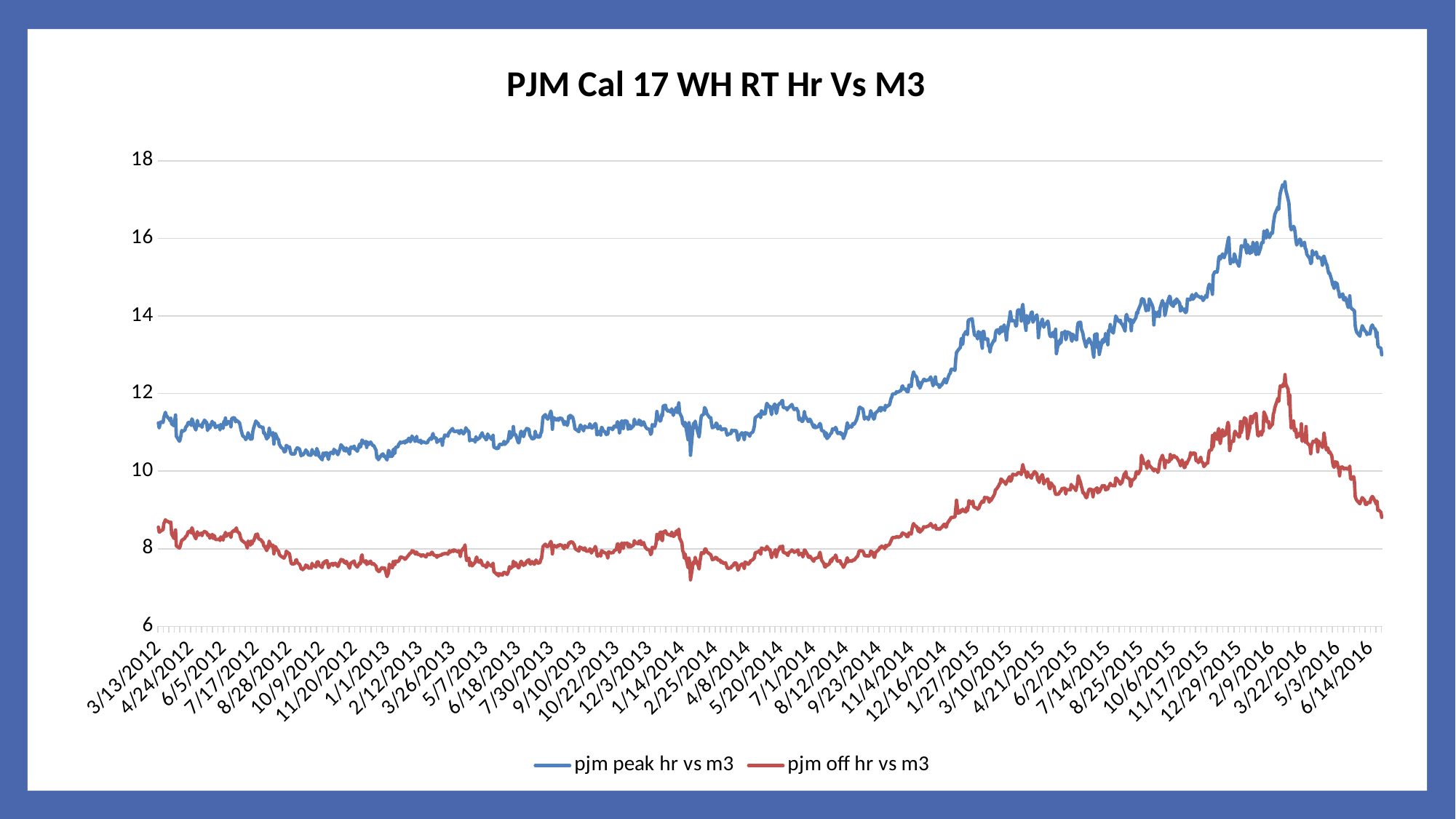
Overall, does pjm peak hr vs m3 rise or fall from 3/13/2012 to its peak around 3/22/2016? rise Is the value for pjm peak hr vs m3 at 3/13/2012 greater or less than 10? greater After its peak around 3/22/2016, does pjm peak hr vs m3 rise or fall toward 6/14/2016? fall What is the title of the chart? PJM Cal 17 WH RT Hr Vs M3 Is the value for pjm off hr vs m3 at 3/13/2012 greater or less than 10? less Is the highest value reached by pjm off hr vs m3 greater or less than 14? less What are the two series named in the legend? pjm peak hr vs m3 and pjm off hr vs m3 Which series has the higher values across the whole chart, pjm peak hr vs m3 or pjm off hr vs m3? pjm peak hr vs m3 How many series does the legend list? 2 What kind of chart is shown on the slide? line chart